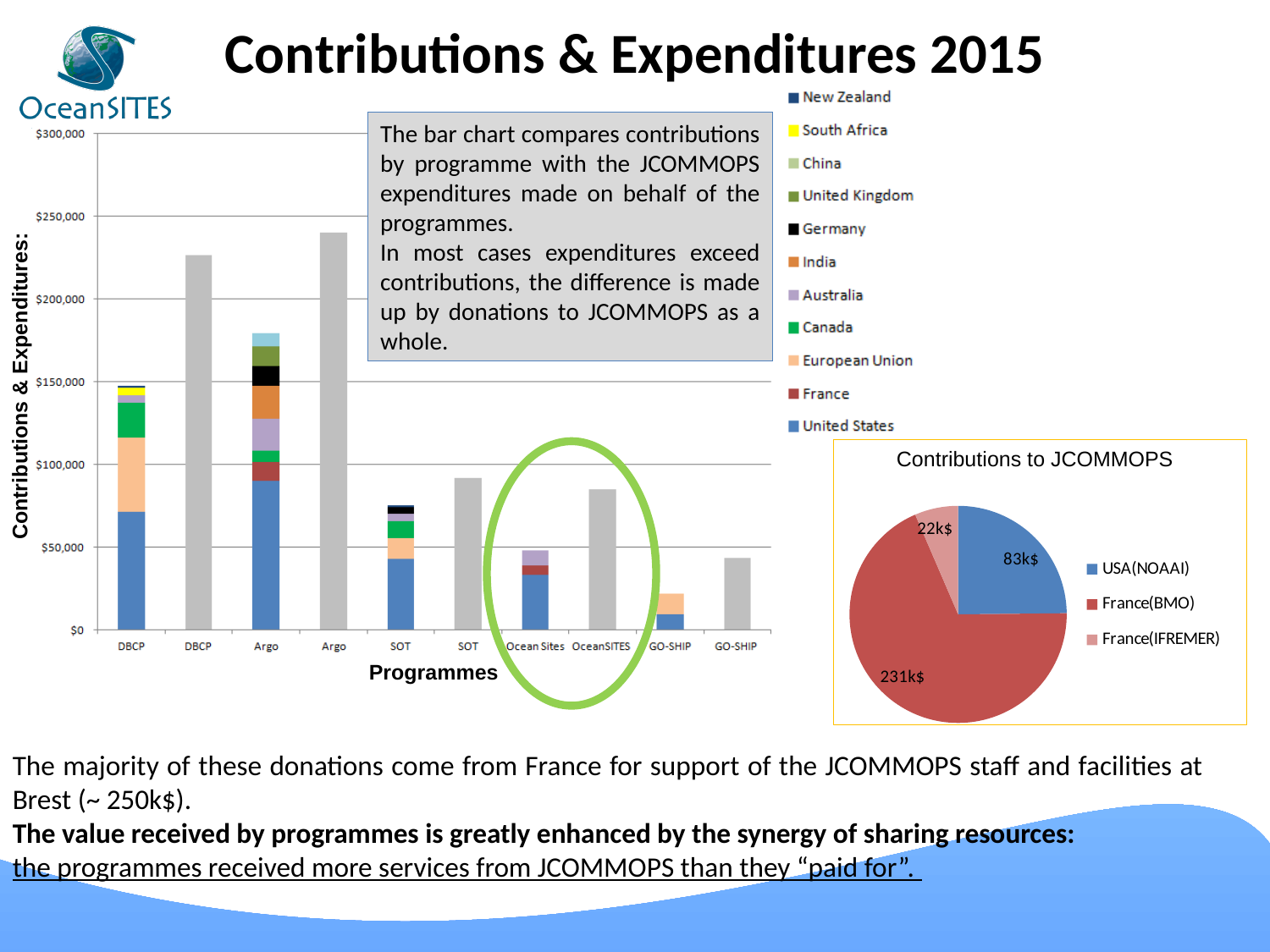
In the pie chart titled 'Contributions to JCOMMOPS', what is the value for France(IFREMER)? 22k$ In the bar chart on the left, is the grey expenditure bar for Argo greater or less than $200,000? greater In the pie chart titled 'Contributions to JCOMMOPS', how much larger is the France(BMO) contribution than the USA(NOAAI) contribution? 148k$ In the pie chart titled 'Contributions to JCOMMOPS', which contributor has the largest slice? France(BMO) In the pie chart titled 'Contributions to JCOMMOPS', which contributor has the smallest slice? France(IFREMER) In the pie chart titled 'Contributions to JCOMMOPS', how many slices are there? 3 In the bar chart on the left, is the grey expenditure bar for GO-SHIP greater or less than $50,000? less In the bar chart on the left, how many bars are plotted along the Programmes axis? 10 In the bar chart on the left, how many series does the legend list? 11 In the pie chart titled 'Contributions to JCOMMOPS', what is the value for France(BMO)? 231k$ What kind of chart is the chart on the left of the slide? bar chart In the pie chart titled 'Contributions to JCOMMOPS', what is the value for USA(NOAAI)? 83k$